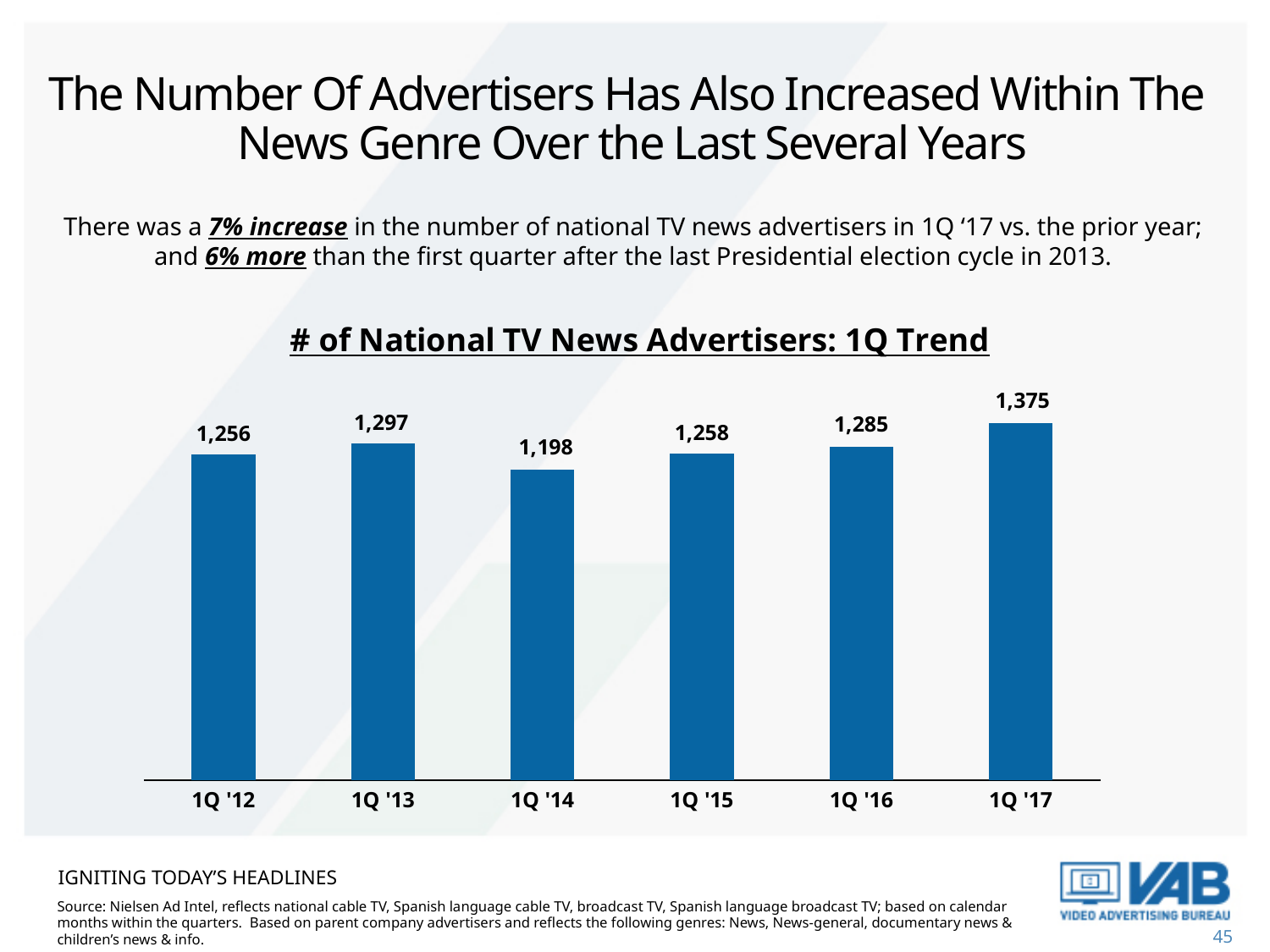
Which quarter has the lowest number of national TV news advertisers? 1Q '14 Which quarter has the highest number of national TV news advertisers? 1Q '17 What is the number of national TV news advertisers in 1Q '17? 1,375 Does the number of advertisers rise or fall from 1Q '14 to 1Q '17? Rise Which is larger, the value for 1Q '13 or the value for 1Q '15? 1Q '13 What kind of chart is shown on the slide? Bar chart What is the difference between the values for 1Q '13 and 1Q '14? 99 What is the number of national TV news advertisers in 1Q '14? 1,198 How many quarters are shown on the chart? 6 What is the title of the chart? # of National TV News Advertisers: 1Q Trend What is the difference between the values for 1Q '17 and 1Q '16? 90 What is the value shown for 1Q '12? 1,256